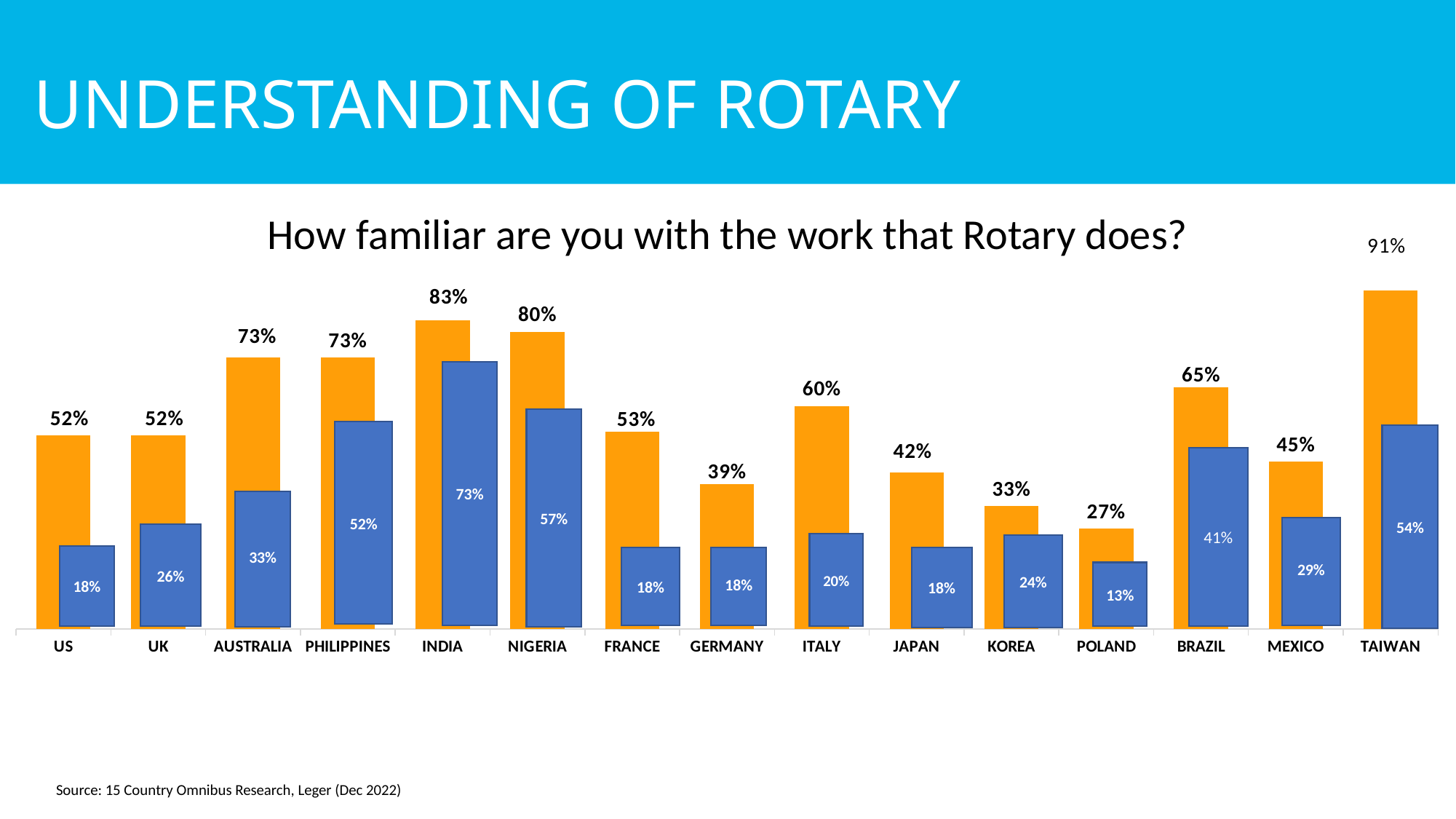
What is the difference between the orange bar values for Nigeria and Germany? 41% Which is larger, the blue bar value for Philippines or the blue bar value for Mexico? Philippines Which country has the lowest blue bar value? Poland Which country has the lowest orange bar value? Poland What is the title of the chart? How familiar are you with the work that Rotary does? How many countries are shown on the x axis of the chart? 15 What type of chart is shown on the slide? Bar chart What is the difference between the orange and blue bar values for Taiwan? 37% What is the value of the orange bar for Poland? 27% Which country has the highest orange bar value? Taiwan What is the value of the blue bar for Brazil? 41% What is the value of the orange bar for India? 83%